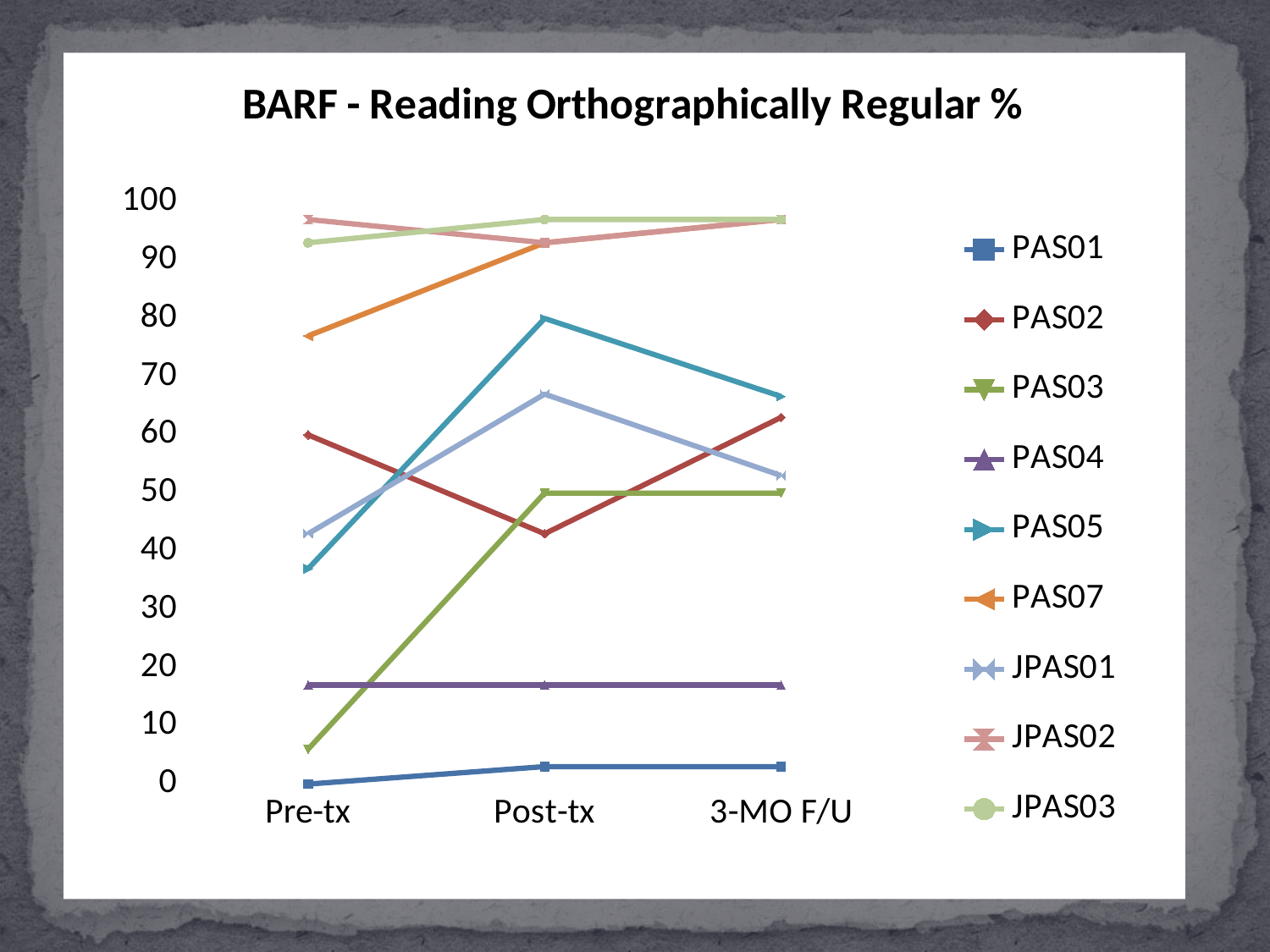
Which series has the highest value at Pre-tx? JPAS02 What kind of chart is shown on the slide? line chart Does the value for PAS03 rise or fall from Pre-tx to Post-tx? rise How many time points are shown on the x axis? 3 Is the value for PAS05 at Post-tx greater or less than 70? greater Is the value for PAS04 at Post-tx greater or less than 20? less How many series does the legend list? 9 At Post-tx, which is larger: the value for PAS05 or the value for PAS02? PAS05 Is the value for PAS07 at Pre-tx greater or less than 70? greater Which series has the lowest value at Pre-tx? PAS01 What is the title of the chart? BARF - Reading Orthographically Regular %